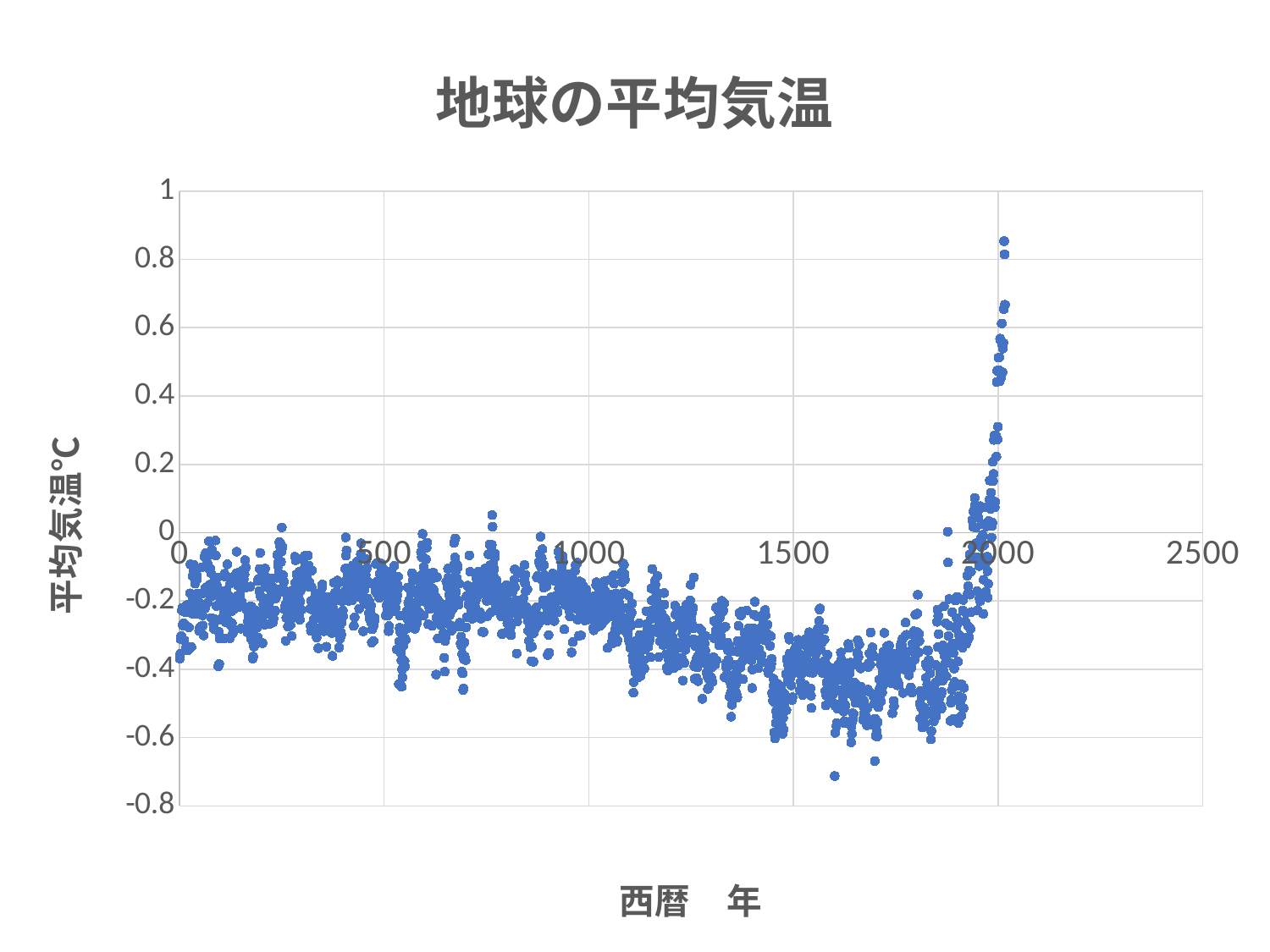
Are the plotted values around the year 500 greater or less than 0? less Around which year on the x axis do the highest plotted values occur? 2000 Which is larger: the plotted values around the year 2000 or the plotted values around the year 1500? around the year 2000 Is the lowest plotted value, near the year 1600, greater or less than -0.6? less Do the plotted values rise or fall between the years 1900 and 2000? rise What is the title of the chart? 地球の平均気温 Are most plotted values around the year 1500 greater or less than -0.2? less What is the label of the vertical axis? 平均気温℃ Do the plotted values generally rise or fall between the years 1000 and 1600? fall What kind of chart is shown on the slide? scatter chart What is the highest value shown on the vertical axis? 1